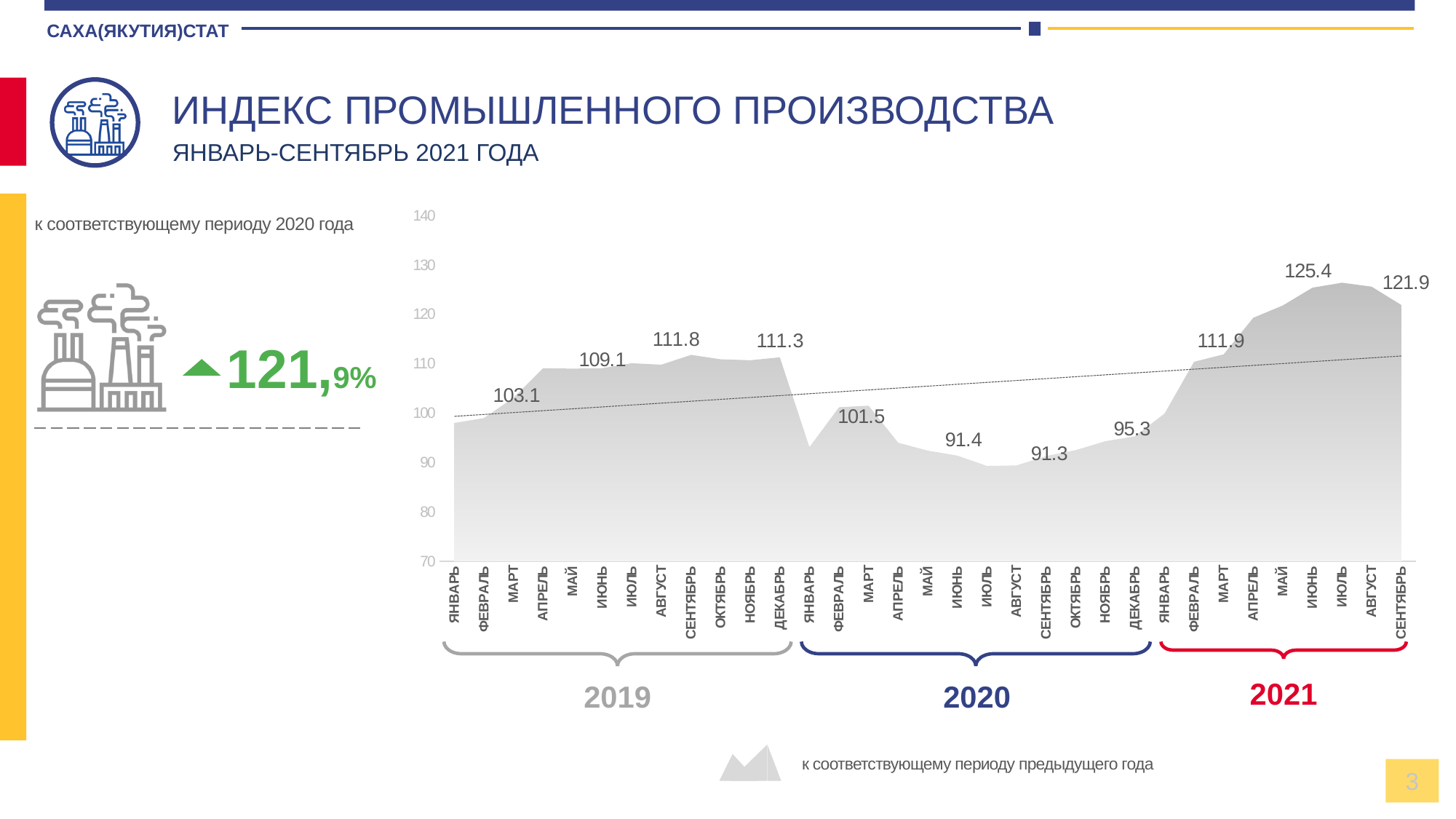
What is the highest data label printed on the chart? 125.4 What is the lowest data label printed on the chart? 91.3 Is the value for January 2020 greater or less than 100? less Which labeled value is larger: 111.8 or 111.3 in 2019? 111.8 Do the values rise or fall from January 2021 to June 2021? rise How many years are marked with brackets under the x axis? 3 How many months are shown for 2021 on the x axis? 9 What is the value labeled at the last point of the chart (September 2021)? 121.9 What type of chart is shown on the slide? area chart What is the difference between the labeled values 125.4 and 121.9 in 2021? 3.5 What is the difference between the labeled values 111.9 and 95.3? 16.6 What large percentage figure is shown on the left side of the slide next to the factory icon? 121,9%